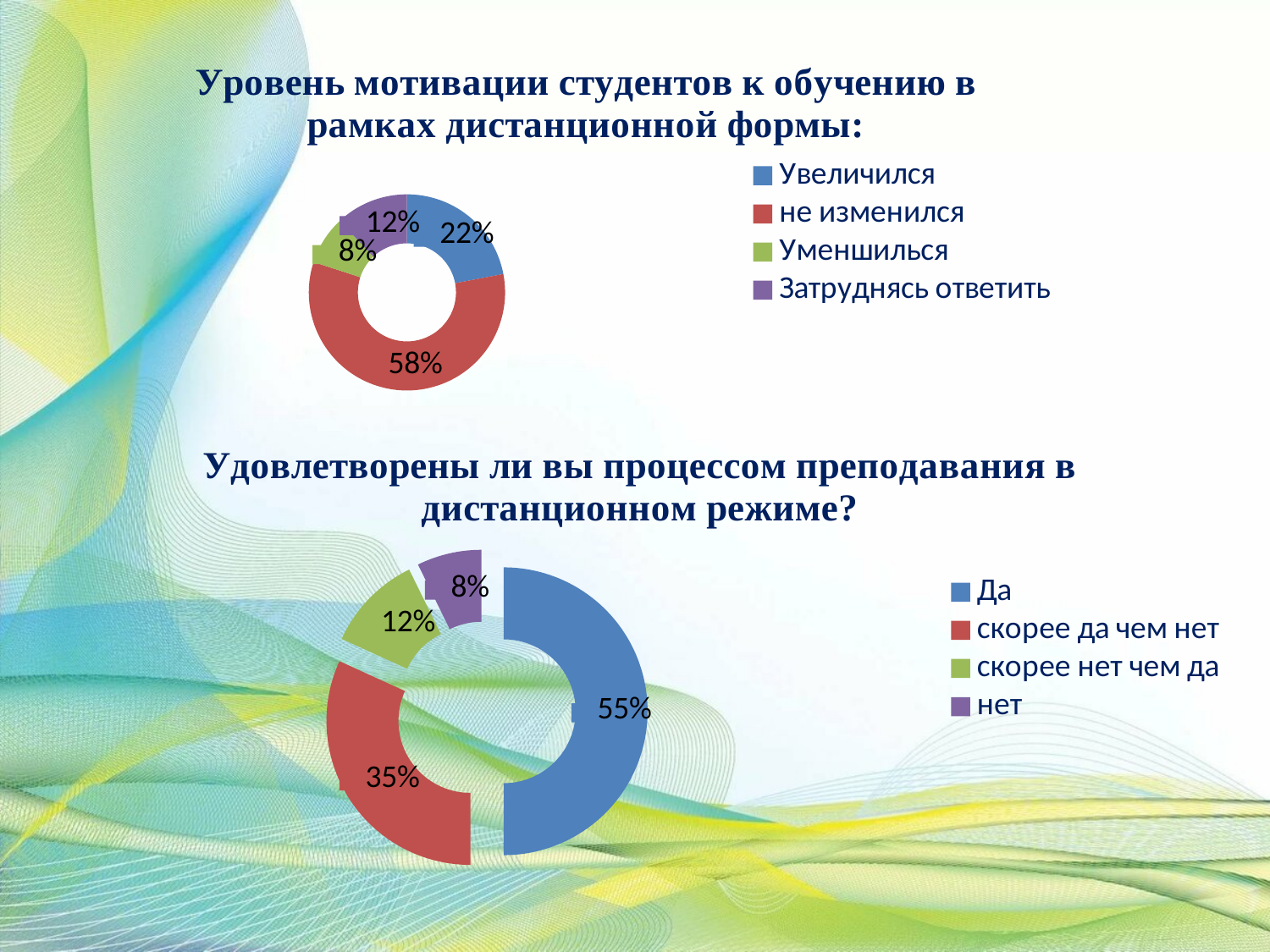
In the bottom chart, what percentage is shown for "скорее нет чем да"? 12% In the bottom chart, which category has the smallest share? нет What type of chart is used for both charts on the slide? Doughnut (pie) chart In the bottom chart ("Удовлетворены ли вы процессом преподавания в дистанционном режиме?"), what percentage answered "Да"? 55% How many categories does the legend of the top chart list? 4 In the top chart, what is the difference between the shares for "не изменился" and "Увеличился"? 36 percentage points In the top chart, which category has the smallest share? Уменшилься In the top chart ("Уровень мотивации студентов к обучению в рамках дистанционной формы"), what percentage is shown for "не изменился"? 58% In the bottom chart, which is larger: the share for "Да" or the share for "скорее да чем нет"? Да In the top chart, which category has the largest share? не изменился In the top chart, what percentage is shown for "Увеличился"? 22% In the bottom chart, what is the combined share of "Да" and "скорее да чем нет"? 90%